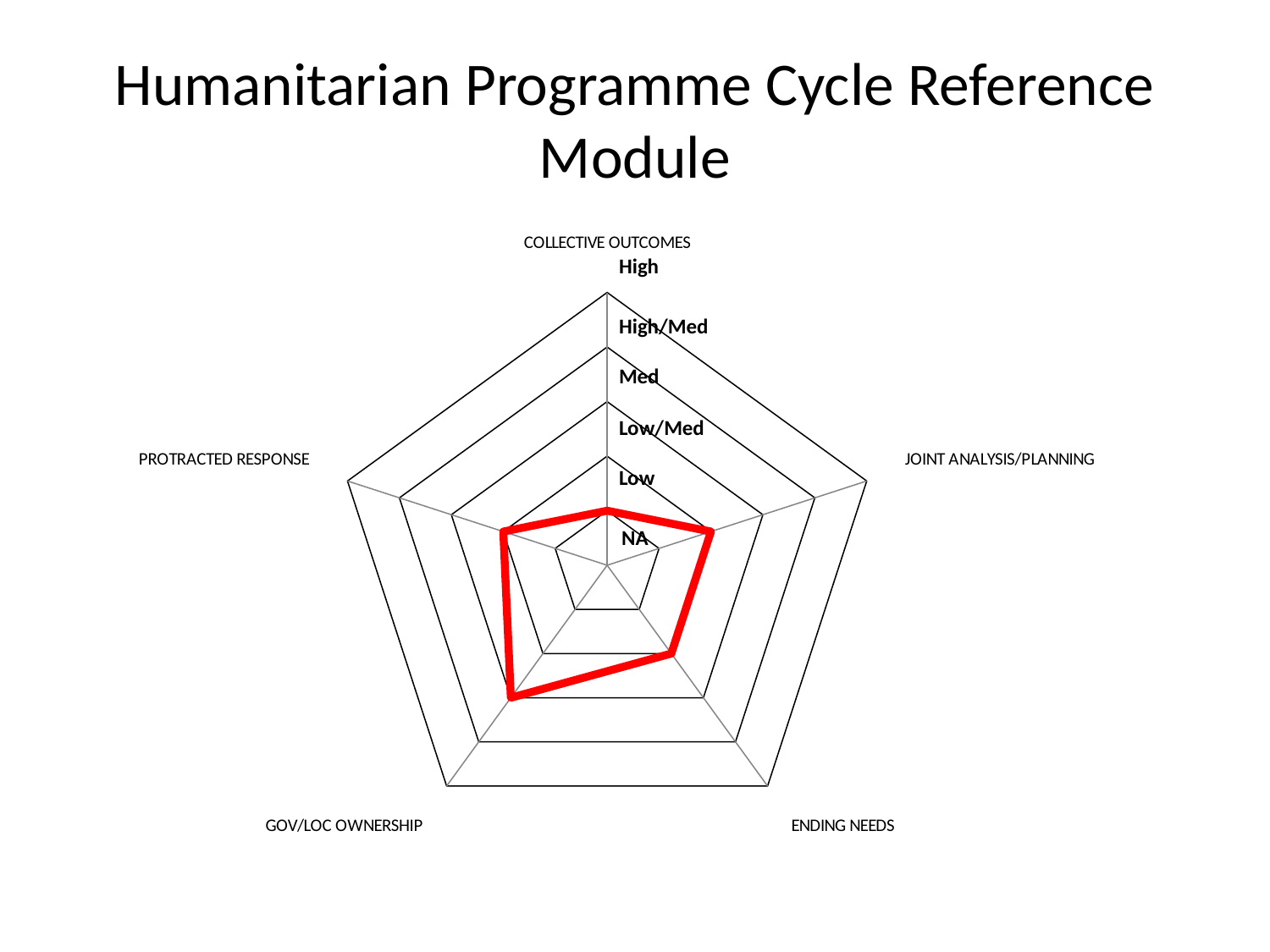
What level does the red line reach on the ENDING NEEDS axis? Low/Med What level does the red line reach on the GOV/LOC OWNERSHIP axis? Med Which category has the lowest rating on the radar chart? COLLECTIVE OUTCOMES What is the title of the slide containing the radar chart? Humanitarian Programme Cycle Reference Module What kind of chart is shown on the slide? Radar chart What level does the red line reach on the JOINT ANALYSIS/PLANNING axis? Low/Med What colour is the data line plotted on the radar chart? Red Which category has the highest rating on the radar chart? GOV/LOC OWNERSHIP What level does the red line reach on the PROTRACTED RESPONSE axis? Low/Med How many categories (axes) does the radar chart have? 5 Which is rated higher, GOV/LOC OWNERSHIP or COLLECTIVE OUTCOMES? GOV/LOC OWNERSHIP What level does the red line reach on the COLLECTIVE OUTCOMES axis? Low